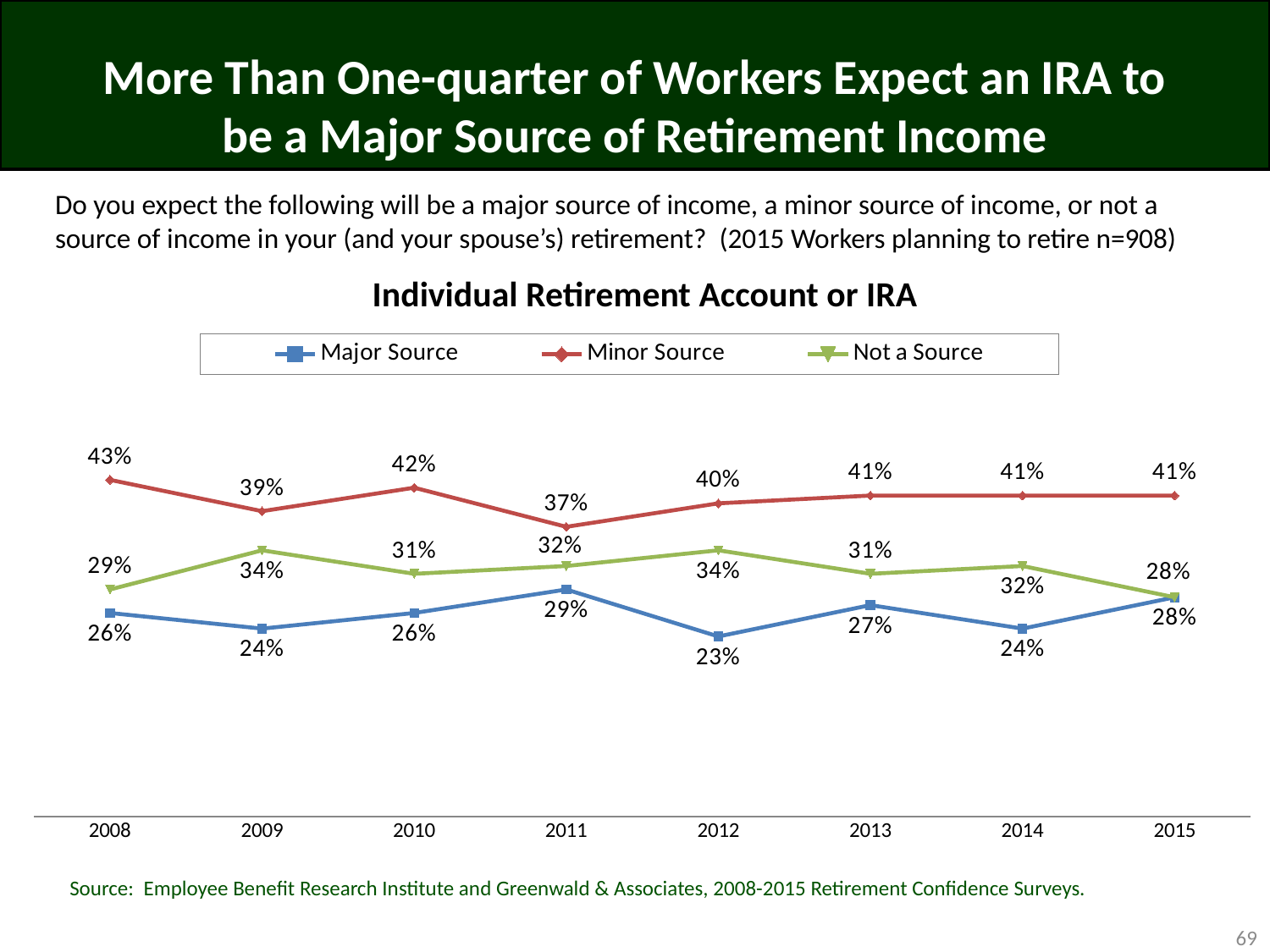
What kind of chart is shown on the slide? Line chart What is the value for Minor Source in 2008? 43% What is the value for Major Source in 2015? 28% In which year is the Major Source value lowest? 2012 What is the difference between the Minor Source and Major Source values in 2012? 17 percentage points Does the Major Source value rise or fall from 2014 to 2015? Rise What is the title of the chart? Individual Retirement Account or IRA How many series does the legend list? 3 How many years are plotted along the x axis? 8 Which year has the larger Not a Source value, 2009 or 2010? 2009 In which year is the Minor Source value highest? 2008 What is the value for Not a Source in 2014? 32%